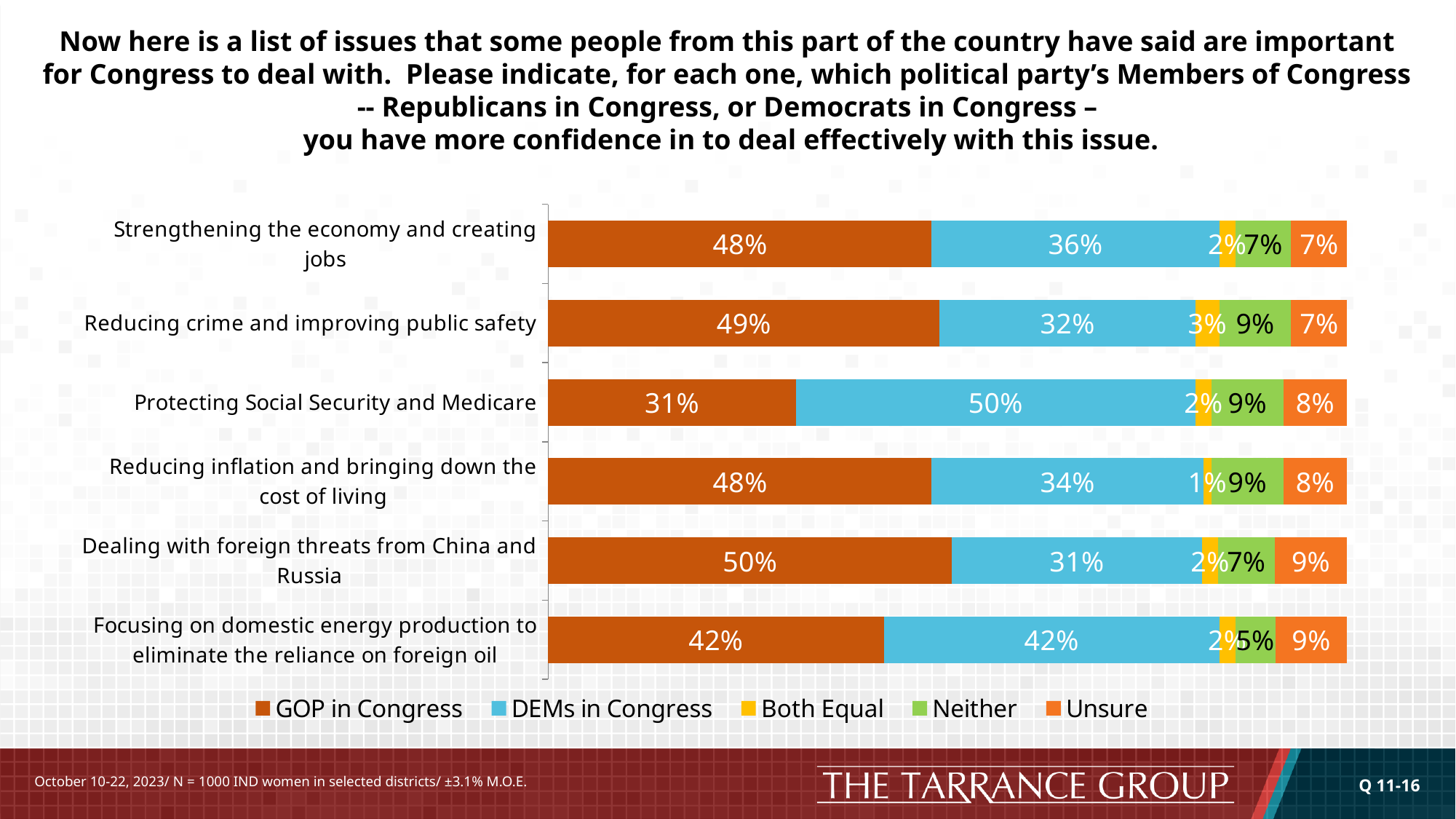
What is the Unsure value for Dealing with foreign threats from China and Russia? 9% What is the Neither value for Focusing on domestic energy production to eliminate the reliance on foreign oil? 5% Which issue has the lowest GOP in Congress value? Protecting Social Security and Medicare What percentage chose DEMs in Congress for Protecting Social Security and Medicare? 50% What kind of chart is shown on the slide? Stacked bar chart How many issues are shown in the chart? 6 What percentage chose GOP in Congress for Strengthening the economy and creating jobs? 48% For Reducing inflation and bringing down the cost of living, which is larger: GOP in Congress or DEMs in Congress? GOP in Congress What is the difference between the GOP in Congress and DEMs in Congress values for Reducing crime and improving public safety? 17 percentage points How many series does the legend list? 5 What is the total of the stacked bar for Strengthening the economy and creating jobs? 100% Which issue has the highest GOP in Congress value? Dealing with foreign threats from China and Russia